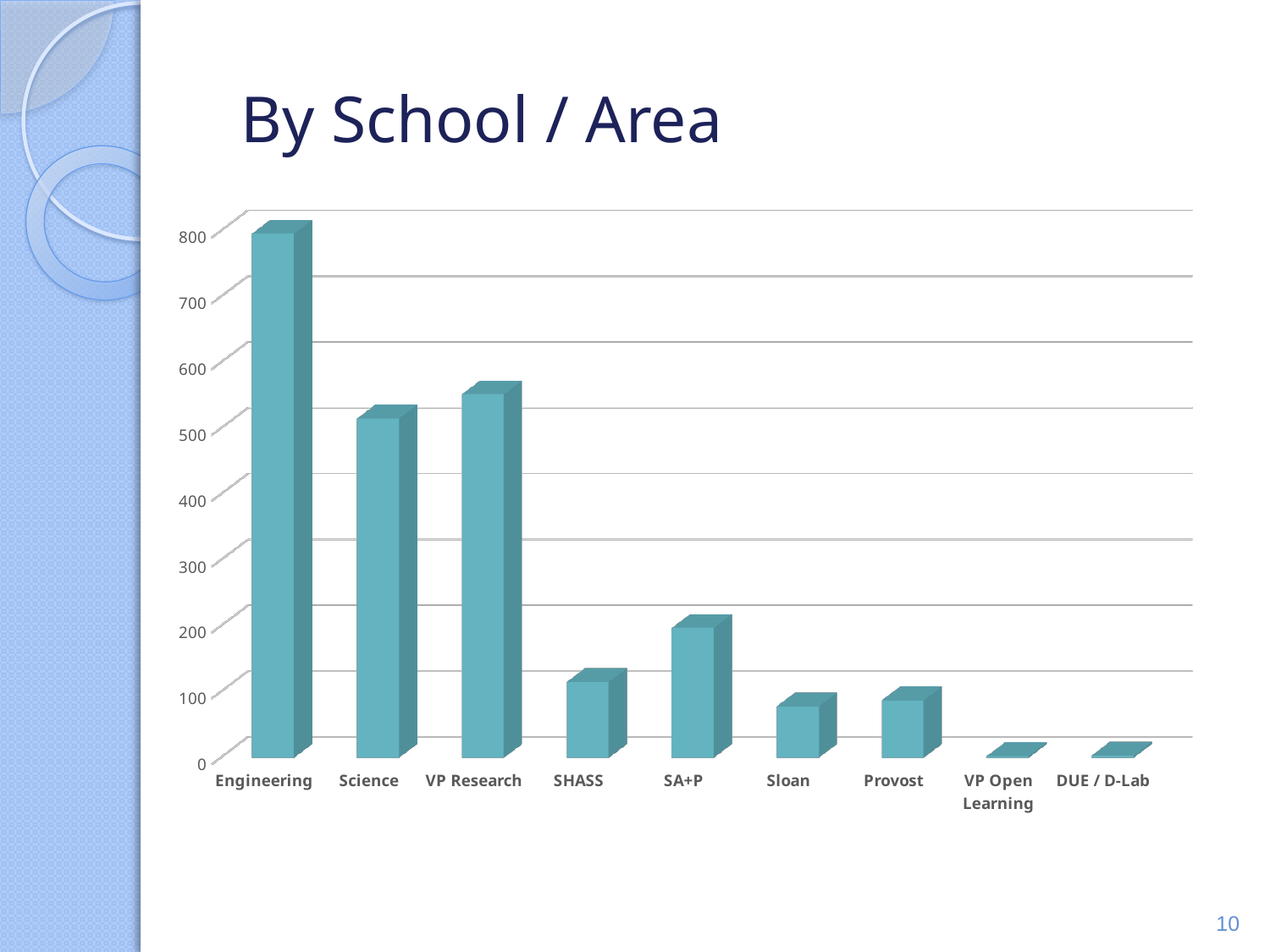
Is the value for SHASS greater or less than 200? less Is the value for VP Open Learning greater or less than 100? less Is the value for Science greater or less than 400? greater Which school/area has the highest bar? Engineering What is the title of the chart? By School / Area How many schools/areas are shown on the x axis of the chart? 9 Which is larger, the value for SA+P or the value for SHASS? SA+P Which is larger, the value for Engineering or the value for Science? Engineering What type of chart is shown on the slide? bar chart